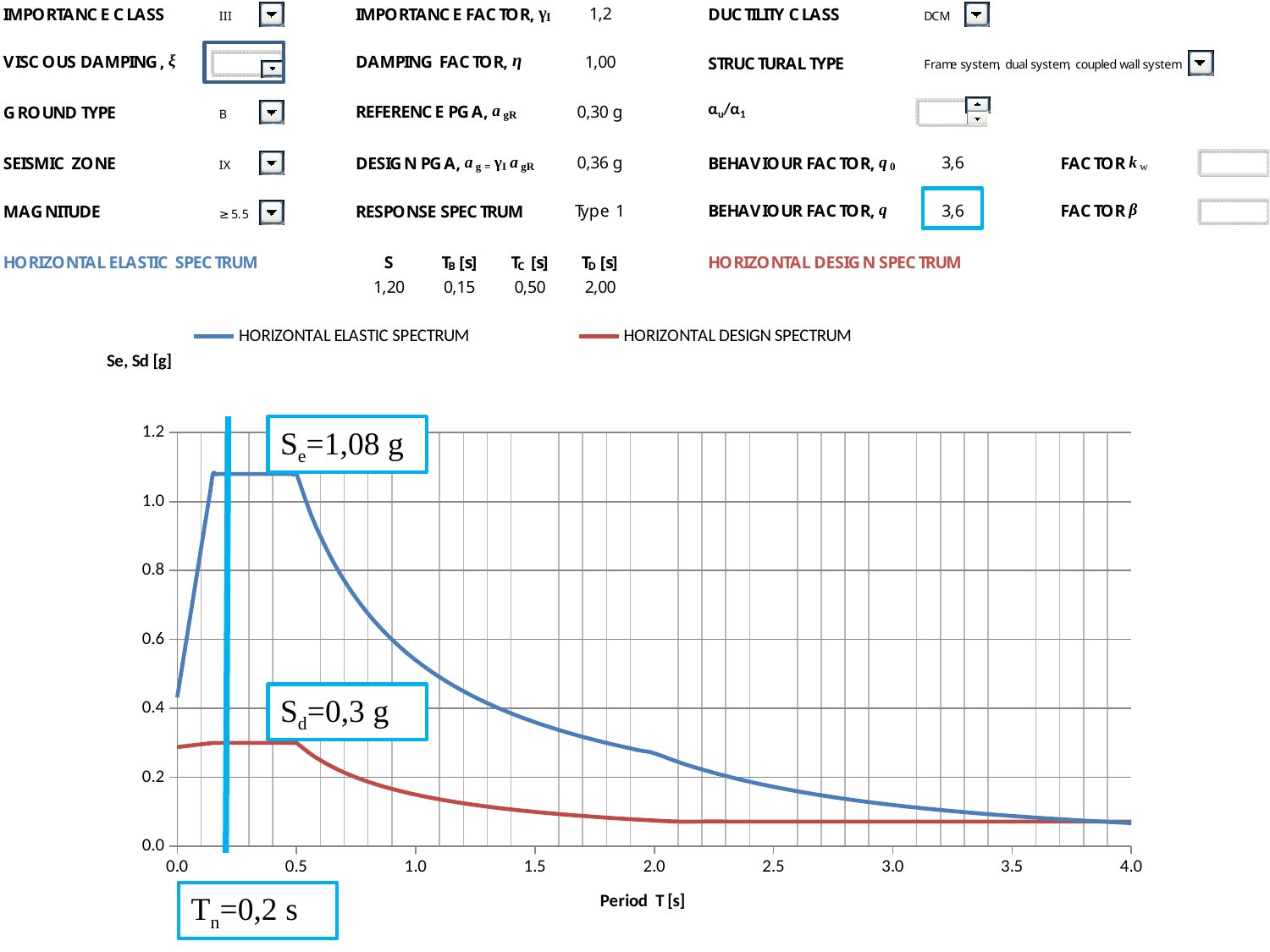
At a period of 1.0 s, which series has the higher value, the horizontal elastic spectrum or the horizontal design spectrum? horizontal elastic spectrum What kind of chart is shown on the slide? line chart What is the maximum value reached by the horizontal elastic spectrum? 1,08 g What is the value of the horizontal design spectrum Sd at the period Tn marked on the chart? 0,3 g What is the label of the x axis of the chart? Period T [s] At a period of 1.0 s, is the horizontal design spectrum value greater or less than 0.2? less At a period of 2.0 s, is the horizontal elastic spectrum value greater or less than 0.4? less What is the maximum value reached by the horizontal design spectrum? 0,3 g What period Tn is marked by the vertical line on the chart? 0,2 s What is the value of the horizontal elastic spectrum Se at the period Tn marked on the chart? 1,08 g Between periods of 0.5 s and 4.0 s, does the horizontal elastic spectrum rise or fall? fall How many series does the chart legend list? 2